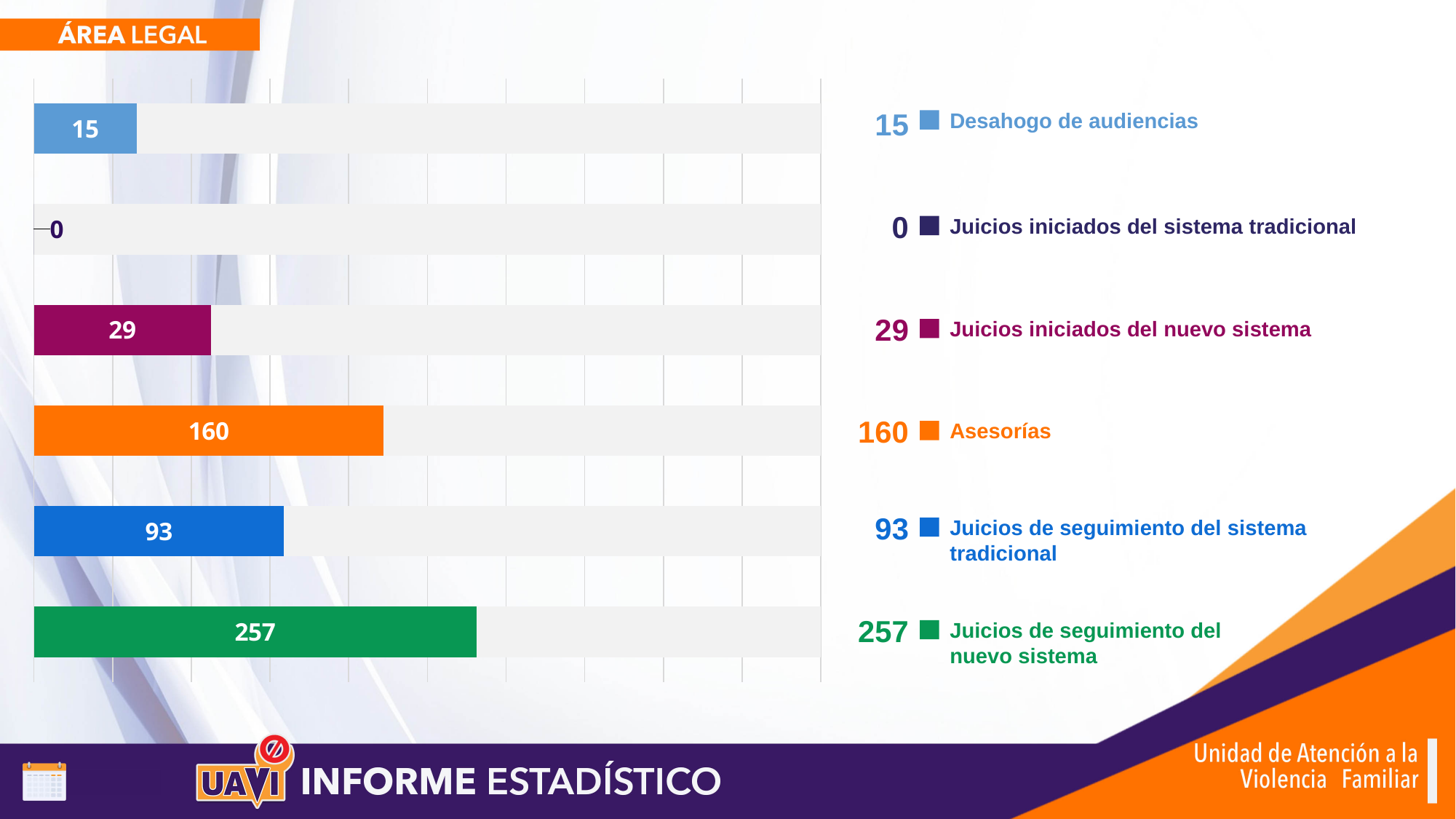
What is the value for Desahogo de audiencias? 15 Which category has the lowest value? Juicios iniciados del sistema tradicional What is the difference between Asesorías and Juicios iniciados del nuevo sistema? 131 What is the value for Juicios iniciados del nuevo sistema? 29 What is the value for Juicios de seguimiento del sistema tradicional? 93 What is the value for Asesorías? 160 What kind of chart is shown on the slide? Bar chart Which is larger, Asesorías or Juicios de seguimiento del sistema tradicional? Asesorías What is the title shown above the chart? ÁREA LEGAL Which category has the highest value? Juicios de seguimiento del nuevo sistema What is the difference between Juicios de seguimiento del nuevo sistema and Juicios de seguimiento del sistema tradicional? 164 How many categories are shown in the chart? 6